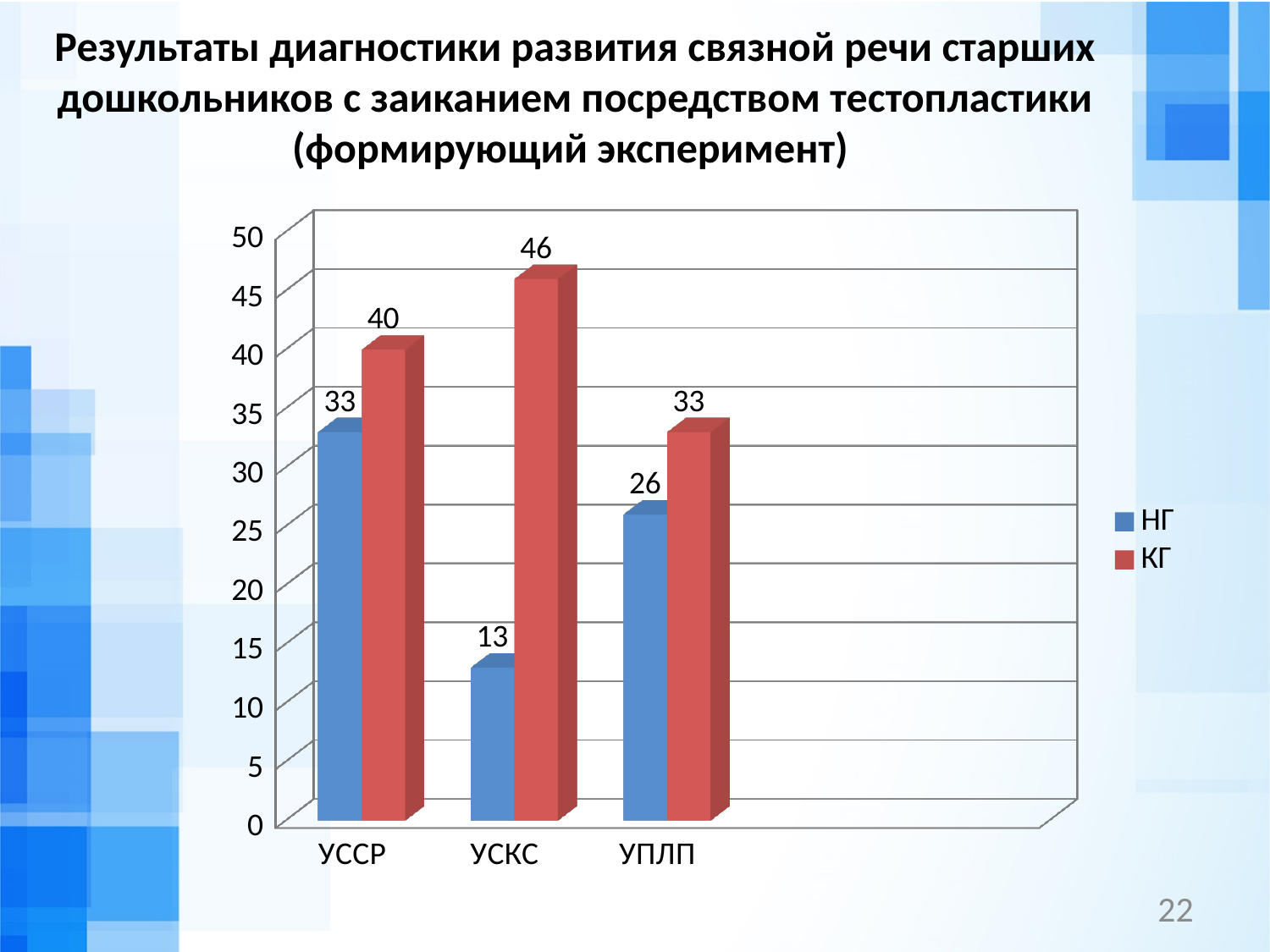
How many series does the legend list? 2 What colour are the КГ bars? red Which category has the lowest НГ value? УСКС What is the value for НГ in the УССР category? 33 What is the value for КГ in the УСКС category? 46 What is the difference between the КГ and НГ values in the УССР category? 7 Which category has the highest КГ value? УСКС How many categories are shown on the x axis? 3 What is the value for НГ in the УПЛП category? 26 Which is larger in the УПЛП category, НГ or КГ? КГ What is the difference between the КГ and НГ values in the УСКС category? 33 What kind of chart is shown on the slide? bar chart